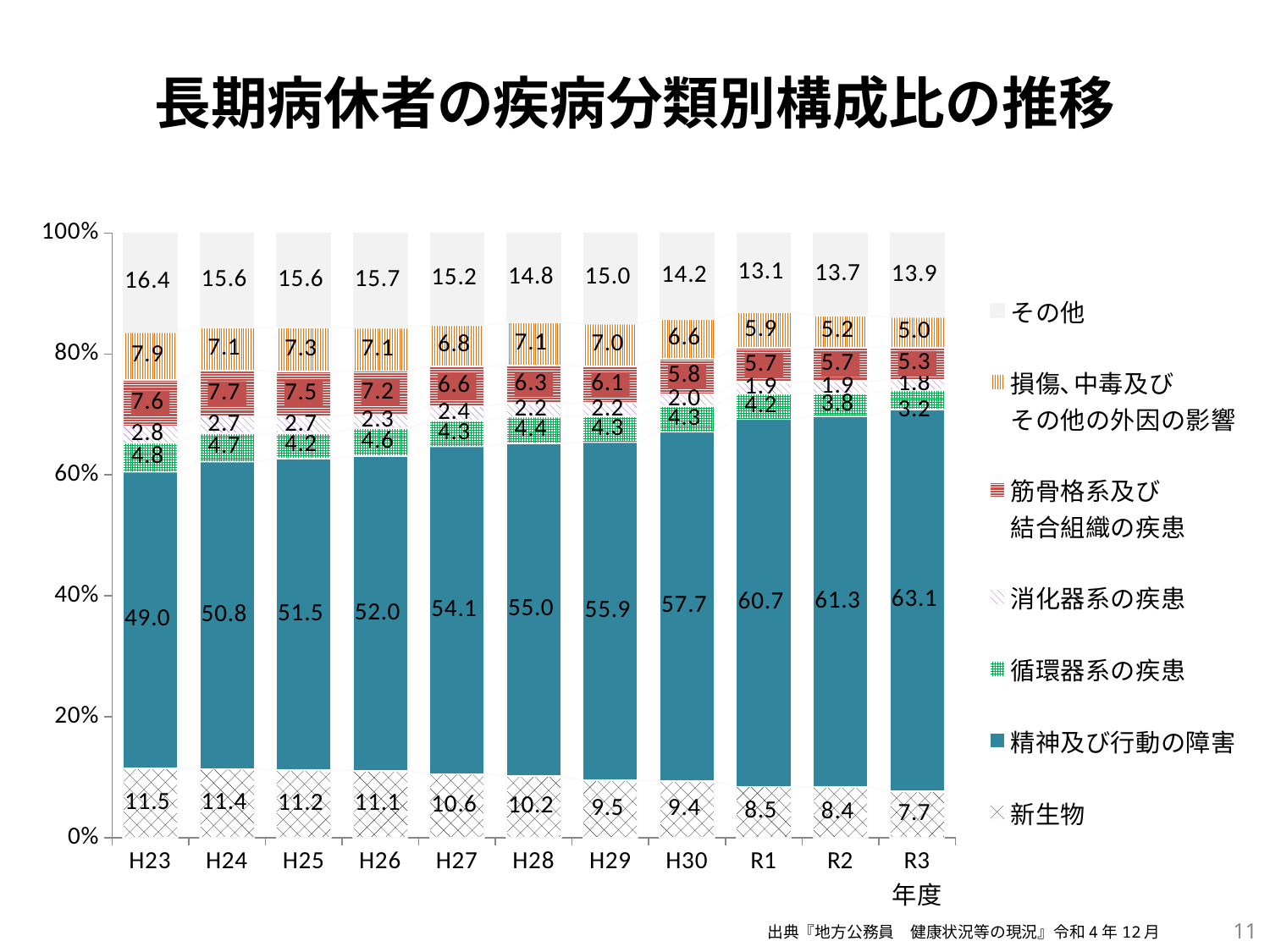
Which is larger, the 精神及び行動の障害 value for H29 or for H30? H30 What is the total of the stacked bar for H23? 100.0 In which fiscal year is the value for その他 the lowest? R1 What is the value for その他 in H30? 14.2 What kind of chart is shown on the slide? Stacked bar chart In which fiscal year is the value for 精神及び行動の障害 the highest? R3 What is the value for 新生物 in H27? 10.6 What is the difference between the 精神及び行動の障害 values for R3 and H23? 14.1 How many series does the legend list? 7 What is the value for 精神及び行動の障害 in R3? 63.1 How many fiscal years (categories) are shown on the x axis? 11 Does the value for 新生物 rise or fall from H23 to R3? Fall